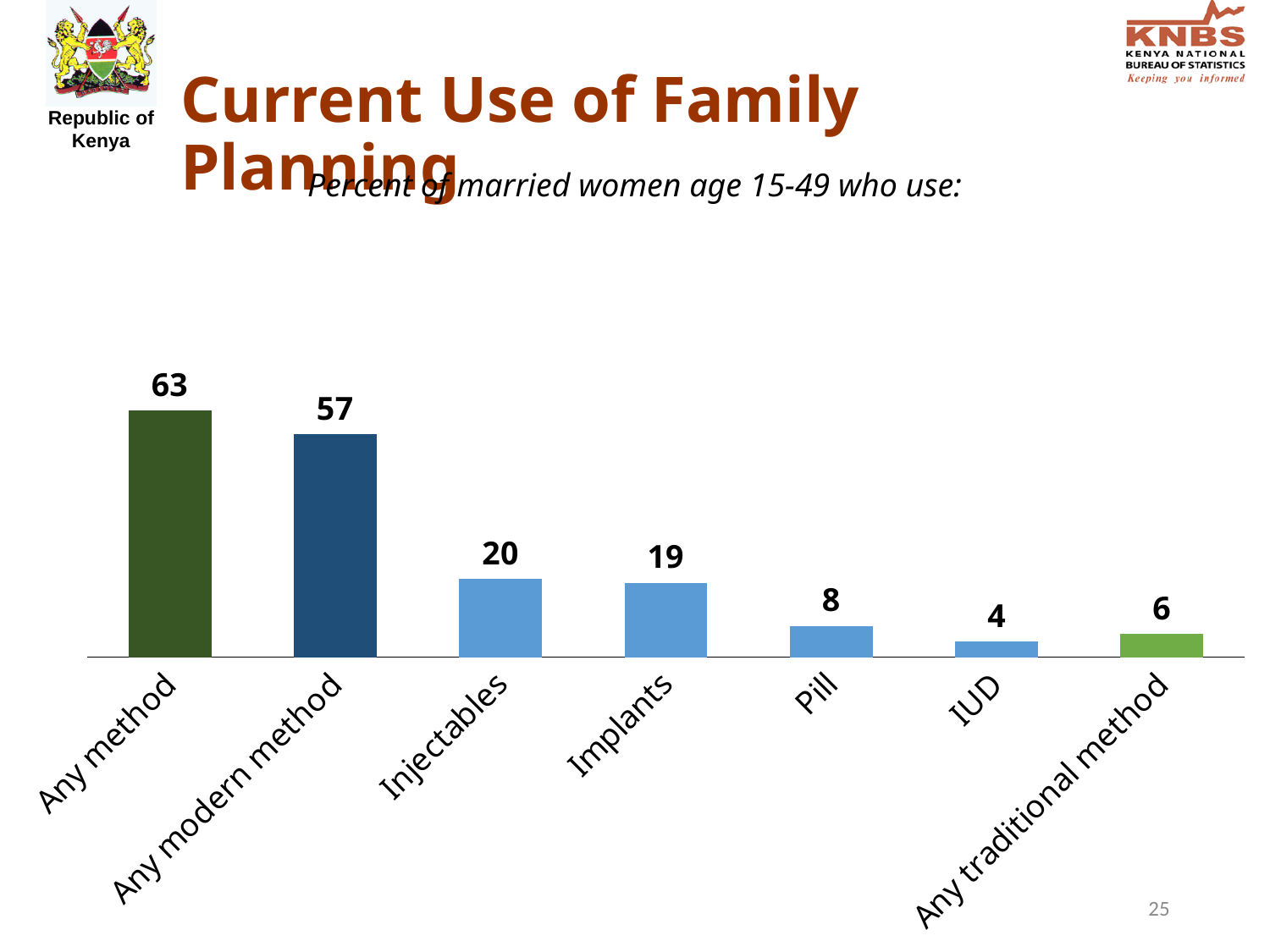
What is the difference between Injectables and Pill? 12 What is the subtitle shown above the chart? Percent of married women age 15-49 who use: Which category has the lowest value? IUD Which category has the highest value? Any method What is the difference between Any method and Any modern method? 6 What is the value for IUD? 4 What is the value for Injectables? 20 What kind of chart is shown on the slide? Bar chart What is the value for Any method? 63 How many categories are shown in the chart? 7 Which is larger, Implants or Pill? Implants What is the value for Any traditional method? 6